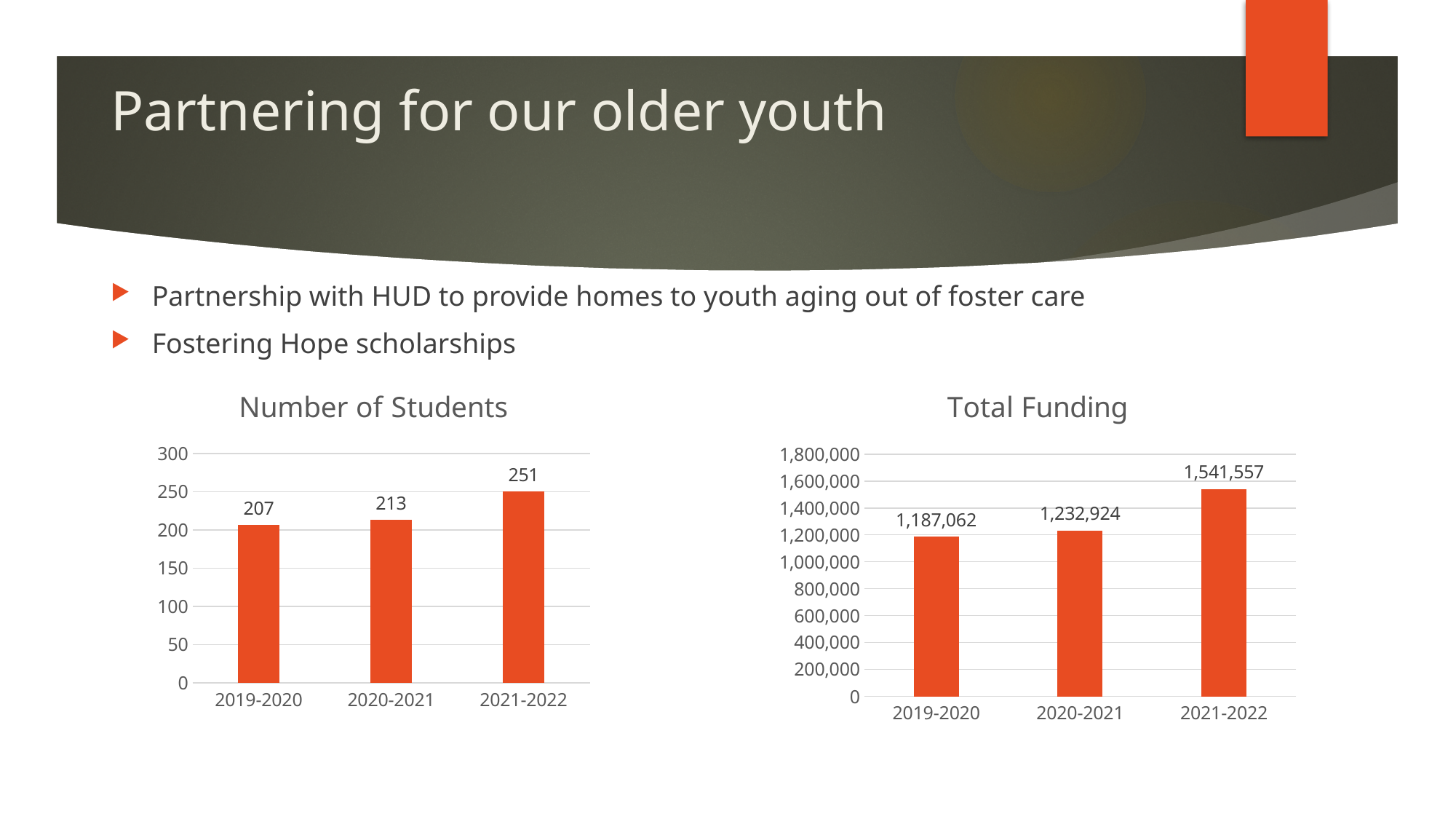
In the 'Number of Students' chart, what is the value for 2019-2020? 207 In the 'Total Funding' chart, what is the difference between the values for 2021-2022 and 2019-2020? 354,495 In the 'Number of Students' chart, what is the value for 2021-2022? 251 How many categories are shown in the 'Number of Students' chart? 3 In the 'Total Funding' chart, is the value for 2021-2022 greater or less than 1,400,000? greater In the 'Number of Students' chart, which year has the highest value? 2021-2022 In the 'Number of Students' chart, what is the difference between the values for 2021-2022 and 2020-2021? 38 In the 'Total Funding' chart, do the values rise or fall from 2019-2020 to 2021-2022? rise In the 'Total Funding' chart, which year has the lowest value? 2019-2020 In the 'Total Funding' chart, what is the value for 2021-2022? 1,541,557 What kind of chart is the 'Total Funding' chart? bar chart In the 'Total Funding' chart, what is the value for 2020-2021? 1,232,924